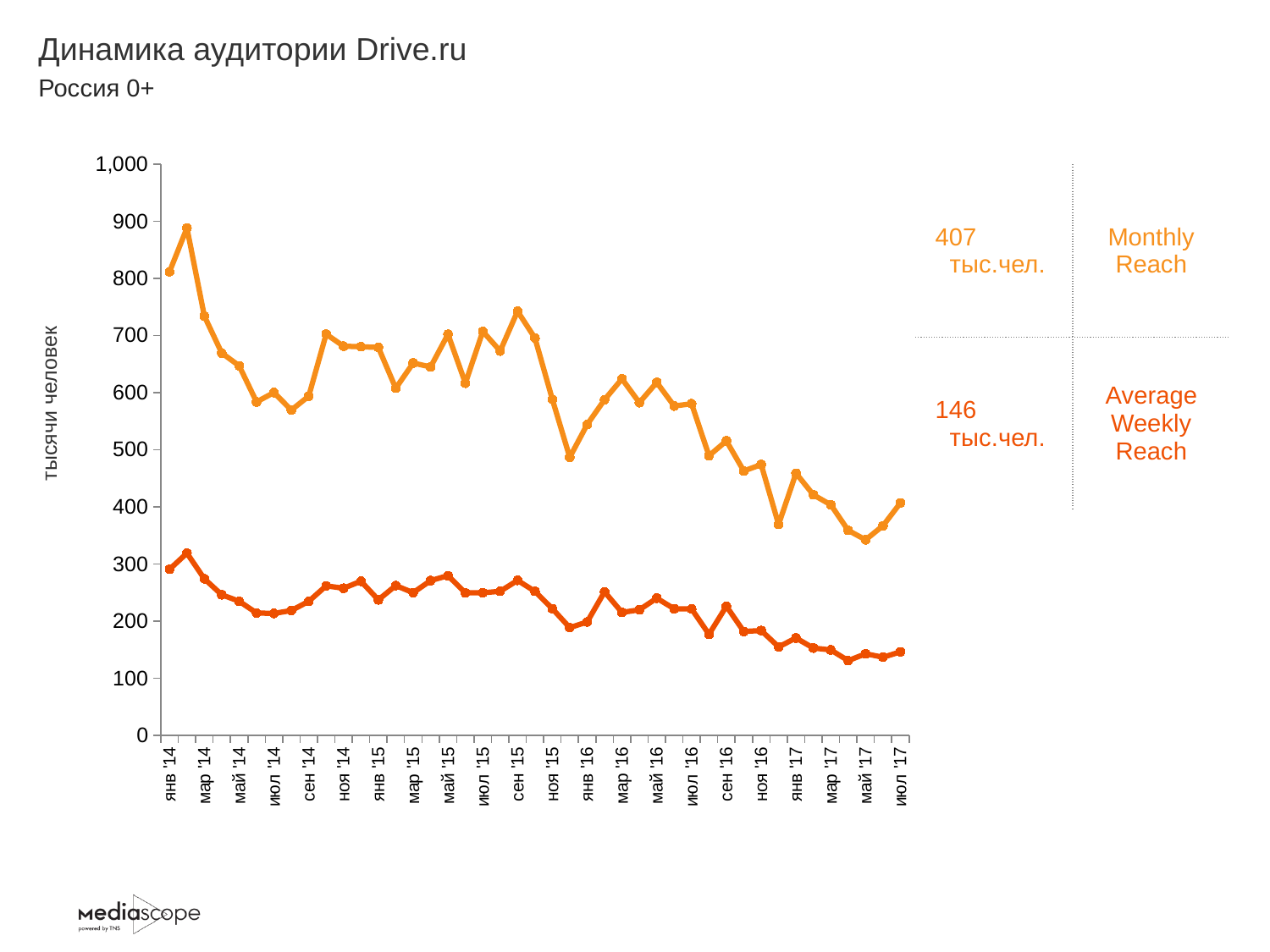
What is the label on the vertical axis of the chart? тысячи человек Is the Average Weekly Reach value for янв '14 greater or less than 200? greater What is the Monthly Reach value shown for the latest month (июл '17)? 407 тыс.чел. What is the difference between the Monthly Reach (407 тыс.чел.) and the Average Weekly Reach (146 тыс.чел.) shown for июл '17? 261 тыс.чел. How many series (lines) are plotted on the chart? 2 Is the Monthly Reach value for янв '14 greater or less than 700? greater What is the Average Weekly Reach value shown for the latest month (июл '17)? 146 тыс.чел. Which is larger: the Monthly Reach in янв '14 or the Monthly Reach in июл '17? янв '14 Which series has the higher values throughout the chart, Monthly Reach or Average Weekly Reach? Monthly Reach Does the Monthly Reach line generally rise or fall from янв '14 to июл '17? fall What kind of chart is shown on the slide? line chart Is the Monthly Reach value for май '17 greater or less than 400? less